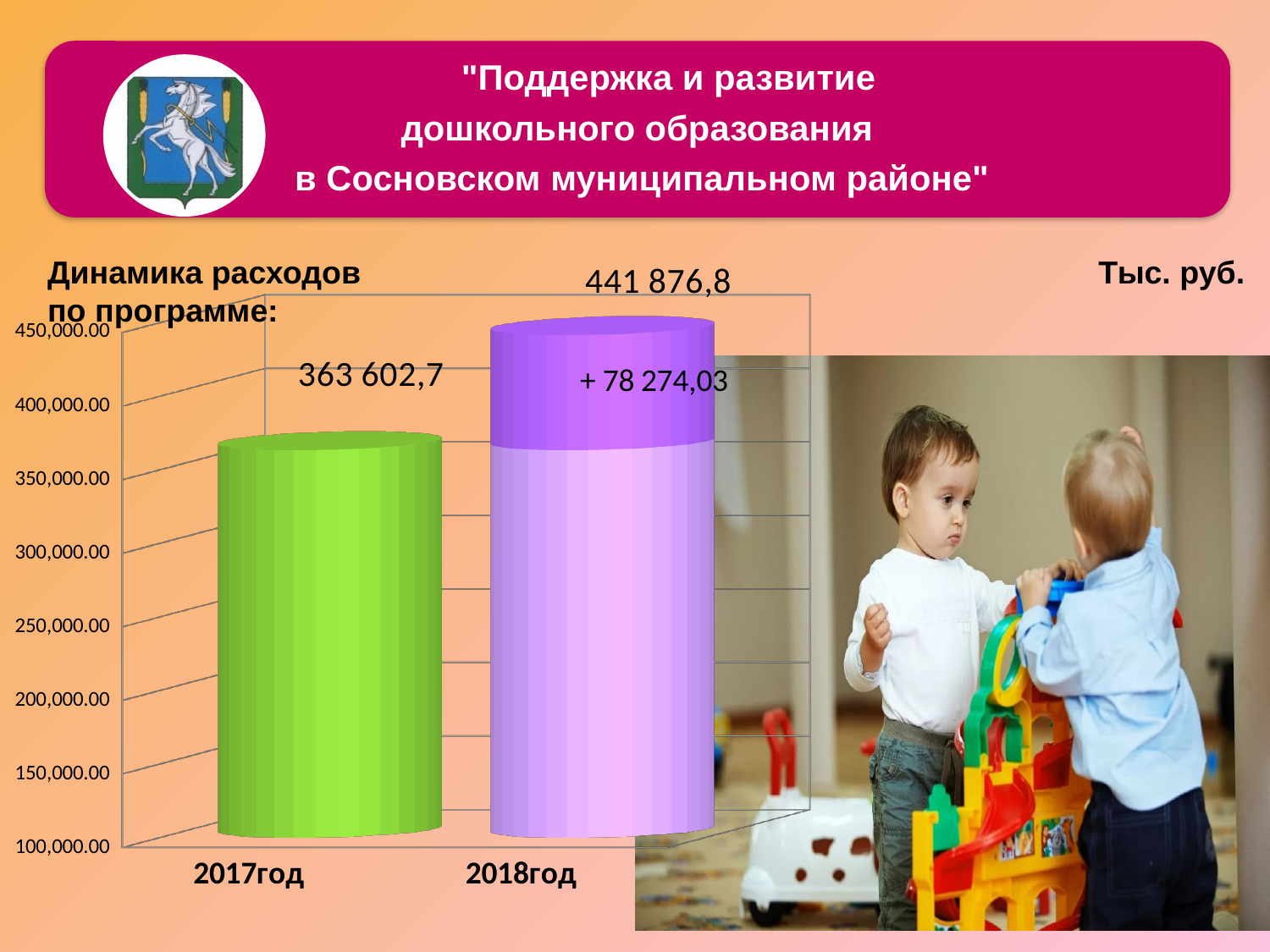
What unit of measurement is indicated for the chart? Тыс. руб. How many categories are shown on the x axis? 2 What is the value for 2018год? 441 876,8 What increase label is printed on the 2018год bar? + 78 274,03 What kind of chart is this? bar chart Which year has the highest expenditure? 2018год Which year has the lowest expenditure? 2017год Do the values rise or fall from 2017год to 2018год? rise What is the value for 2017год? 363 602,7 Which is larger, the value for 2017год or for 2018год? 2018год Is the value for 2018год greater or less than 400,000.00? greater Is the value for 2017год greater or less than 350,000.00? greater